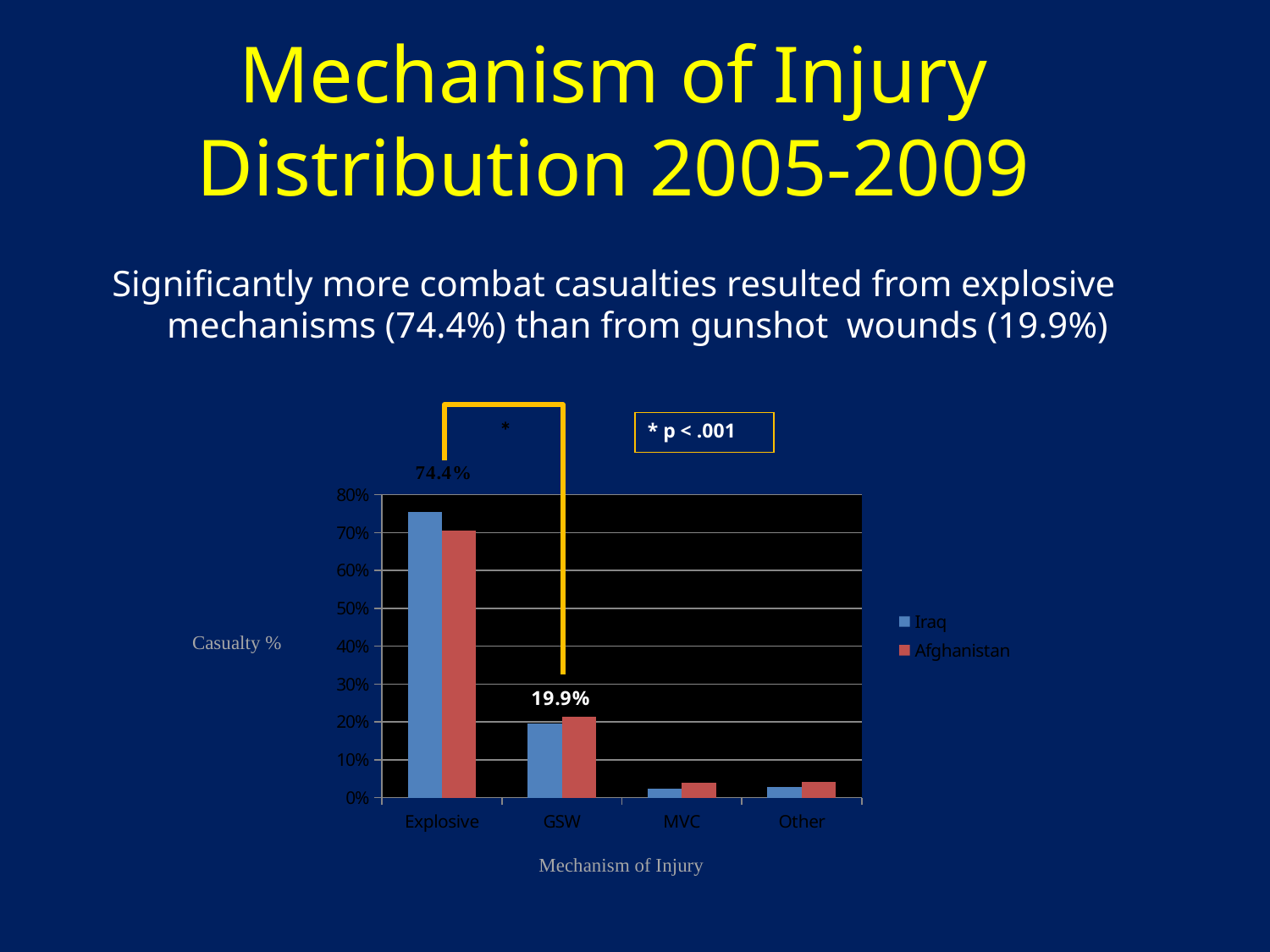
How many mechanism-of-injury categories are shown on the x axis? 4 What percentage label is printed above the GSW bars? 19.9% What kind of chart is shown on the slide? bar chart Which series are listed in the legend? Iraq and Afghanistan Is the Iraq value for MVC greater or less than 10%? less What percentage label is printed above the Explosive bars? 74.4% Is the Afghanistan value for GSW greater or less than 30%? less What is the title of the y axis? Casualty % Is the Iraq value for Explosive greater or less than 70%? greater For the Explosive category, which series has the larger value, Iraq or Afghanistan? Iraq How many series does the legend list? 2 Which mechanism of injury has the highest casualty percentage for Iraq? Explosive